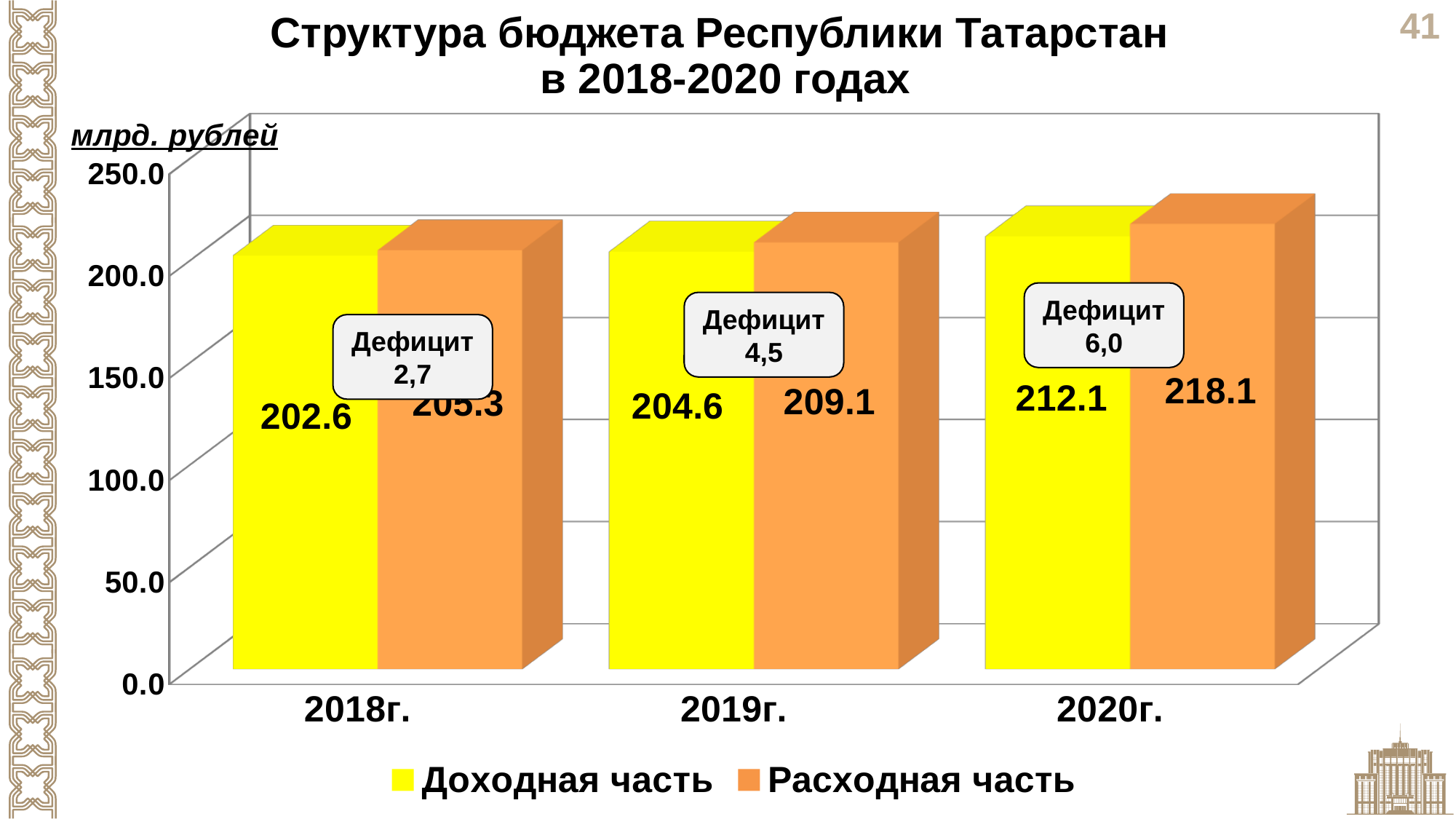
What is the value of Расходная часть for 2020г.? 218.1 What is the value of Доходная часть for 2020г.? 212.1 What type of chart is shown on the slide? bar chart What deficit (Дефицит) is shown for 2019г.? 4,5 How many series does the legend list? 2 Does the value of Доходная часть rise or fall from 2018г. to 2020г.? rise Which year has the highest value of Расходная часть? 2020г. What is the difference between Расходная часть and Доходная часть in 2020г.? 6.0 What is the value of Расходная часть for 2019г.? 209.1 How many years are shown on the x axis? 3 What is the value of Доходная часть for 2018г.? 202.6 Which year has the lowest value of Доходная часть? 2018г.